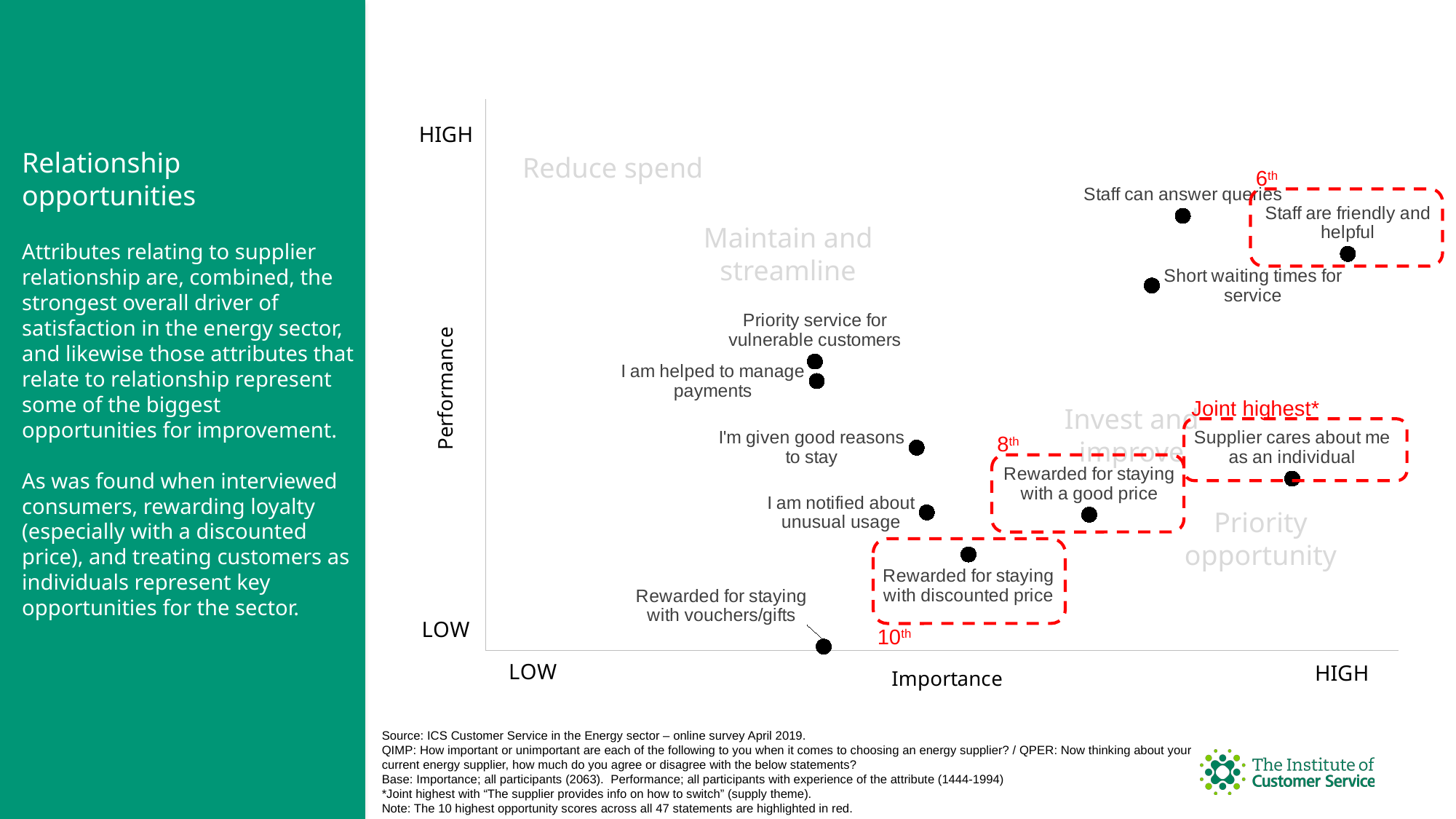
What is the label of the horizontal axis? Importance Which attribute has the highest importance on the chart? Staff are friendly and helpful What kind of chart is shown on the slide? Scatter chart Which attribute has the lowest performance on the chart? Rewarded for staying with vouchers/gifts Which attribute is marked as 6th in the opportunity ranking? Staff are friendly and helpful How many data points are plotted on the chart? 11 What is the label of the vertical axis? Performance Which has higher performance: 'Rewarded for staying with a good price' or 'Rewarded for staying with discounted price'? Rewarded for staying with a good price Which attribute is marked as 10th in the opportunity ranking? Rewarded for staying with discounted price Which attribute is marked as 'Joint highest*' on the chart? Supplier cares about me as an individual Which has higher performance: 'Staff can answer queries' or 'Short waiting times for service'? Staff can answer queries Which attribute has the highest performance on the chart? Staff can answer queries